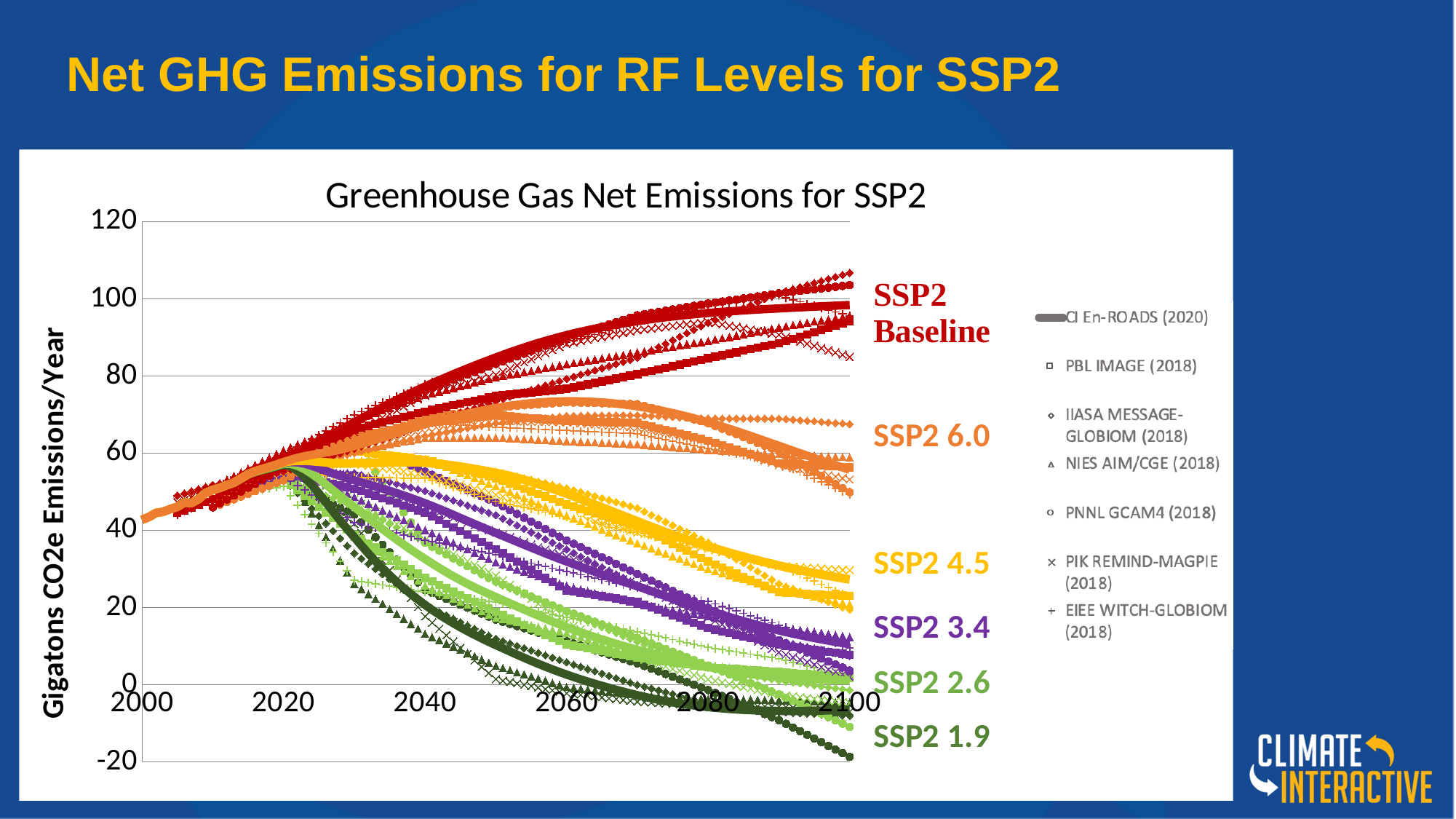
Is the value for SSP2 6.0 in 2100 greater or less than 40? greater Is the value for SSP2 Baseline in 2100 greater or less than 80? greater Which scenario has higher emissions in 2100, SSP2 3.4 or SSP2 6.0? SSP2 6.0 Which scenario has the lowest emissions in 2100? SSP2 1.9 Is the value for SSP2 4.5 in 2100 greater or less than 40? less How many models are listed in the chart's legend? 7 What is the label on the vertical axis of the chart? Gigatons CO2e Emissions/Year Do the SSP2 Baseline emissions rise or fall between 2020 and 2100? rise What is the title of the chart? Greenhouse Gas Net Emissions for SSP2 Which scenario has the highest emissions in 2100? SSP2 Baseline How many SSP2 scenarios are labelled on the right side of the chart? 6